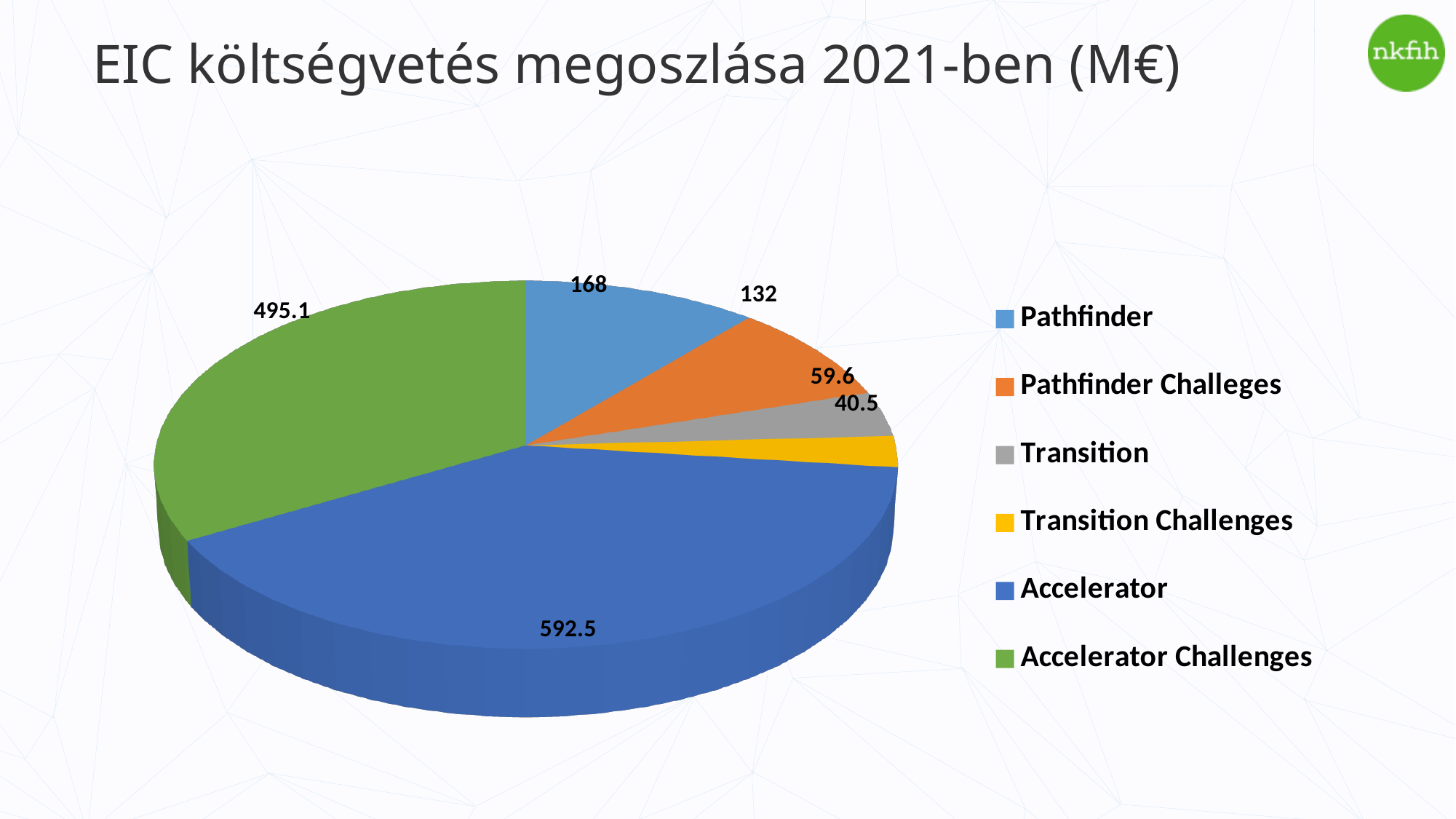
Which category has the smallest slice? Transition Challenges What is the value for Accelerator? 592.5 What is the value for Accelerator Challenges? 495.1 What is the difference between the values for Pathfinder and Pathfinder Challeges? 36 What is the title of the slide? EIC költségvetés megoszlása 2021-ben (M€) What is the difference between the values for Accelerator and Accelerator Challenges? 97.4 What is the value for Transition Challenges? 40.5 What kind of chart is shown on the slide? pie chart How many slices does the pie chart have? 6 Which category has the largest slice? Accelerator What is the value for Pathfinder? 168 Which is larger, the value for Transition or the value for Pathfinder Challeges? Pathfinder Challeges